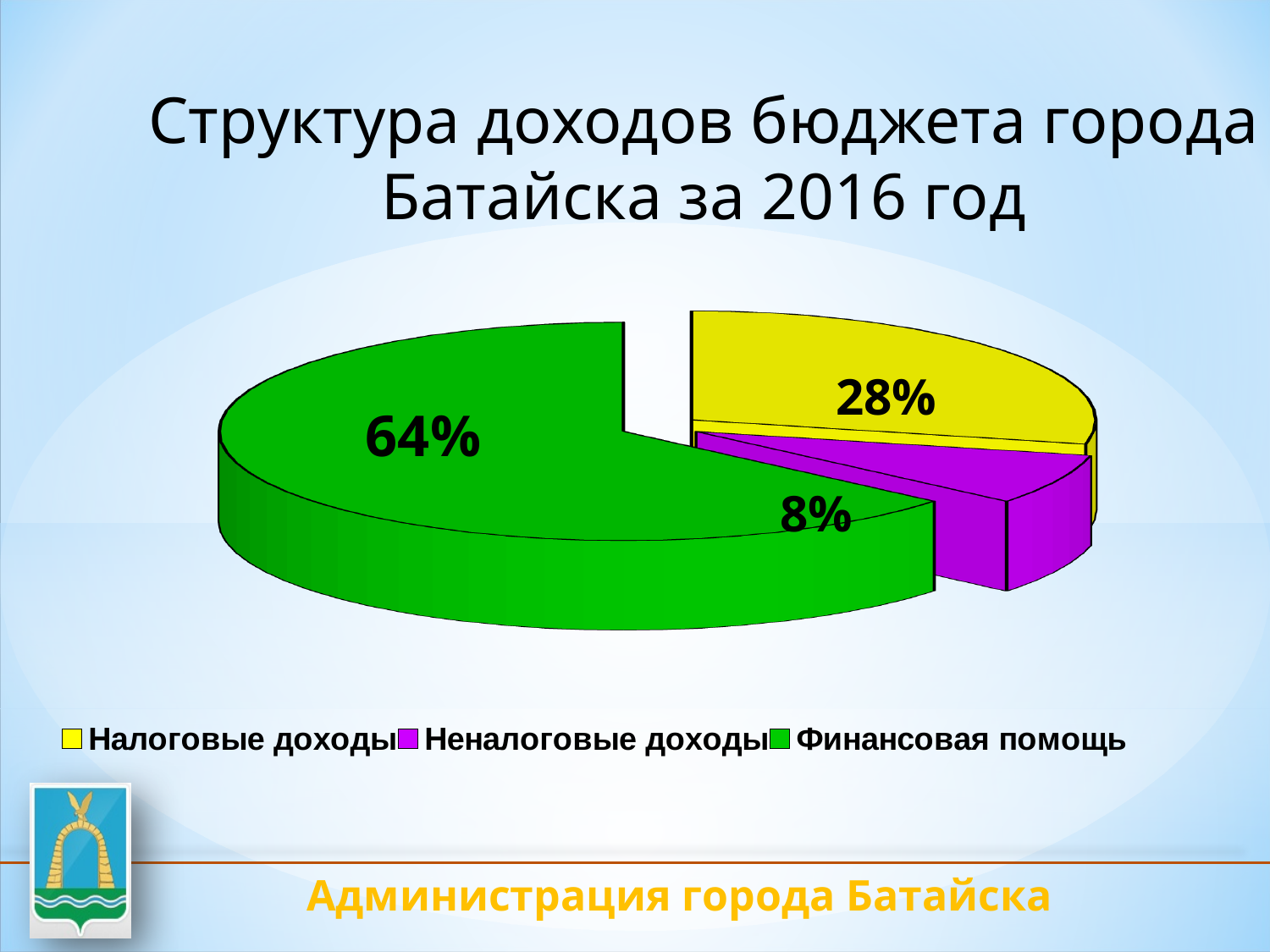
Which category has the smallest slice of the pie? Неналоговые доходы Which is larger: the share for Налоговые доходы or the share for Неналоговые доходы? Налоговые доходы What share of the pie does Финансовая помощь account for? 64% What share of the pie does Налоговые доходы account for? 28% What colour is the slice for Неналоговые доходы? Purple Which category has the largest slice of the pie? Финансовая помощь How many slices does the pie chart have? 3 What is the difference in percentage points between Налоговые доходы and Неналоговые доходы? 20 What kind of chart is shown on the slide? Pie chart What is the title of the slide containing the chart? Структура доходов бюджета города Батайска за 2016 год What is the difference in percentage points between Финансовая помощь and Налоговые доходы? 36 What share of the pie does Неналоговые доходы account for? 8%